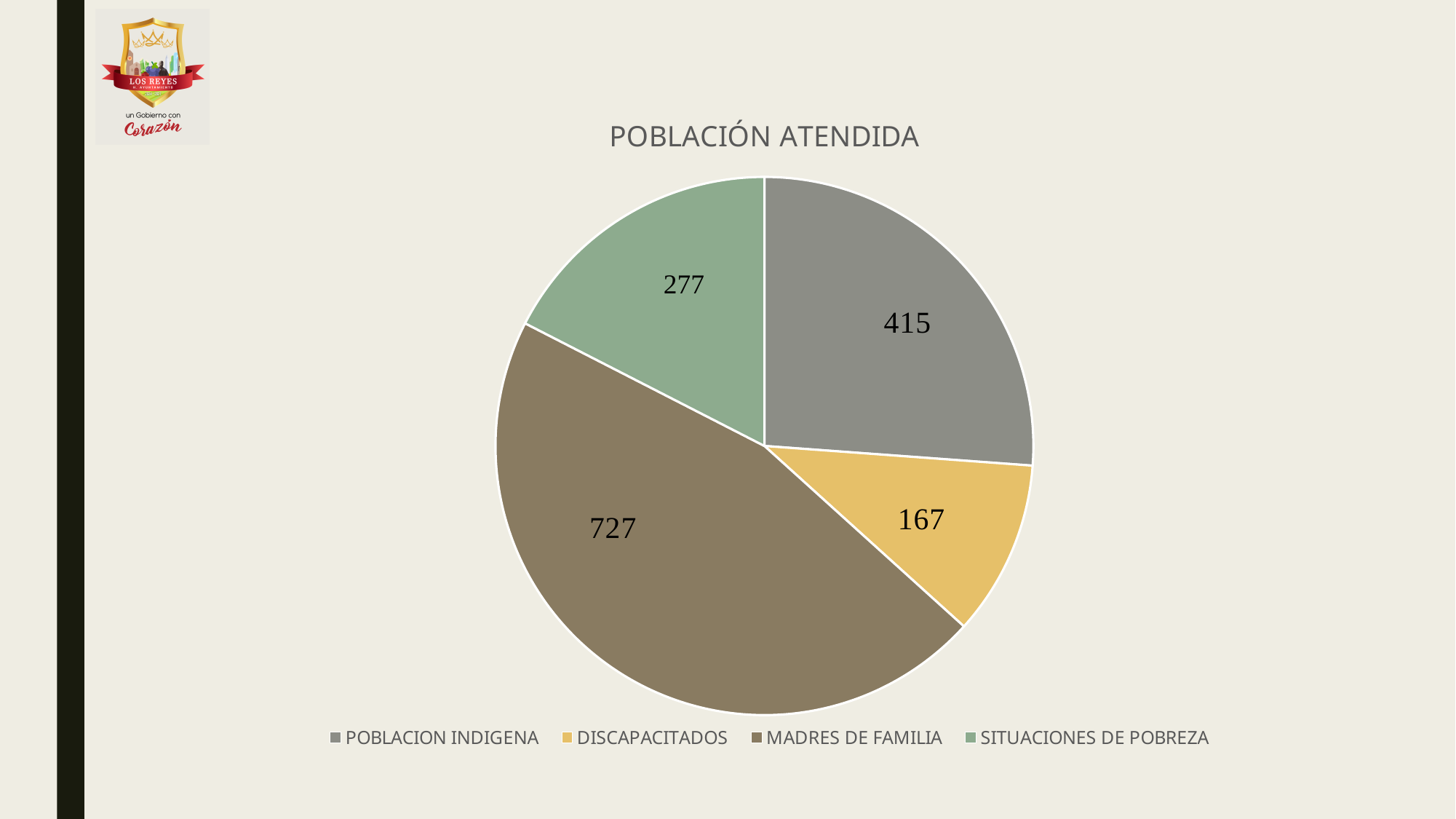
What is the total of all the slices in the pie chart? 1586 Which category has the smallest slice? DISCAPACITADOS What is the value for SITUACIONES DE POBREZA? 277 Which is larger, the value for SITUACIONES DE POBREZA or the value for DISCAPACITADOS? SITUACIONES DE POBREZA What kind of chart is shown on the slide? Pie chart What is the value for POBLACION INDIGENA? 415 How many categories are shown in the pie chart? 4 What is the value for MADRES DE FAMILIA? 727 What is the title of the chart? POBLACIÓN ATENDIDA What is the value for DISCAPACITADOS? 167 Which category has the largest slice? MADRES DE FAMILIA What is the difference between the values for MADRES DE FAMILIA and POBLACION INDIGENA? 312